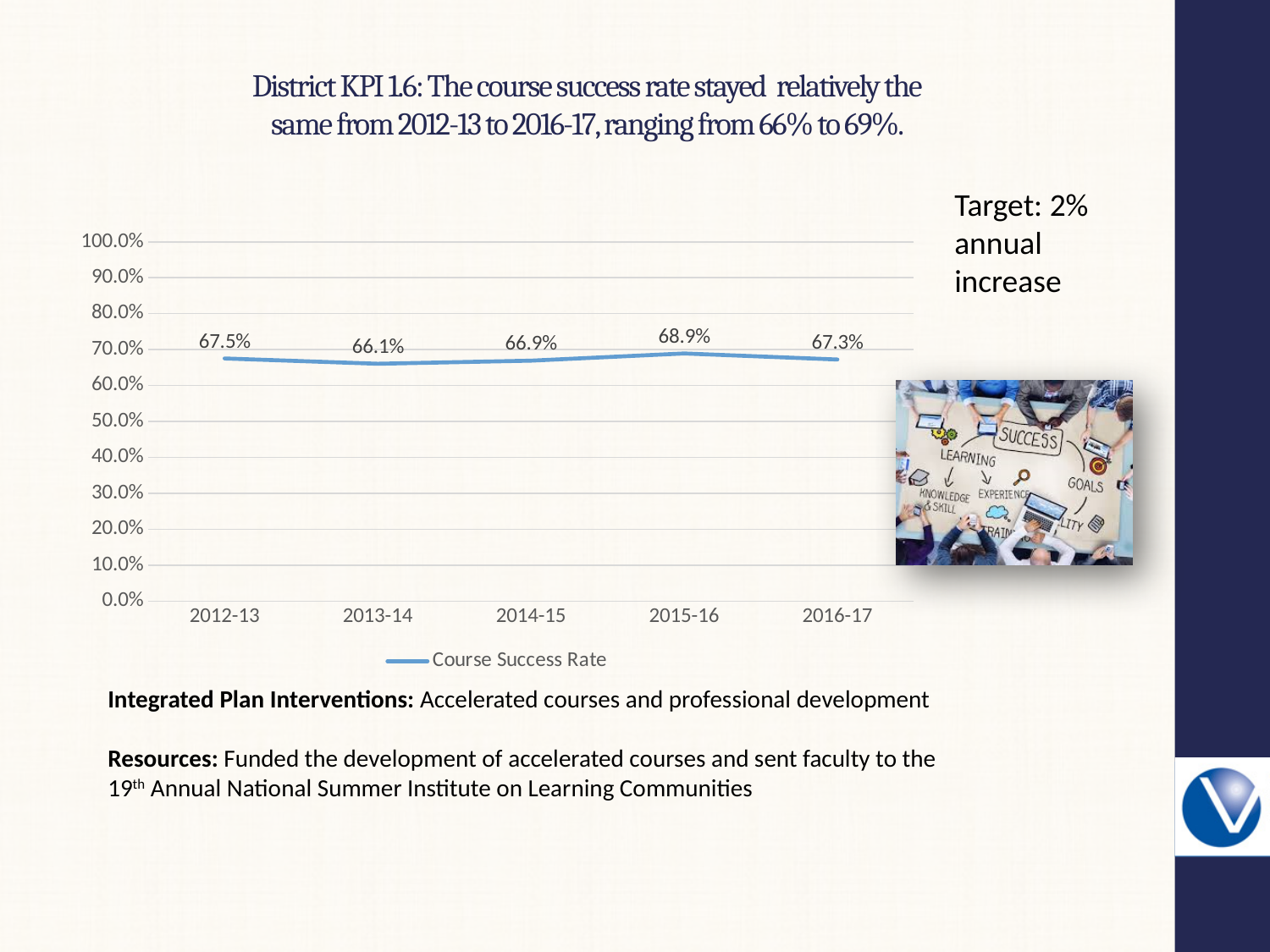
Is the course success rate for 2014-15 greater or less than 70.0%? less What is the course success rate for 2015-16? 68.9% How many years are plotted on the chart? 5 What is the course success rate for 2012-13? 67.5% Which year has the highest course success rate? 2015-16 Which year has the lowest course success rate? 2013-14 What is the name of the series shown in the chart legend? Course Success Rate Which year has a higher course success rate, 2012-13 or 2013-14? 2012-13 What is the difference between the course success rate in 2015-16 and 2013-14? 2.8% What kind of chart is shown on the slide? line chart What is the course success rate for 2016-17? 67.3% How many series does the legend list? 1